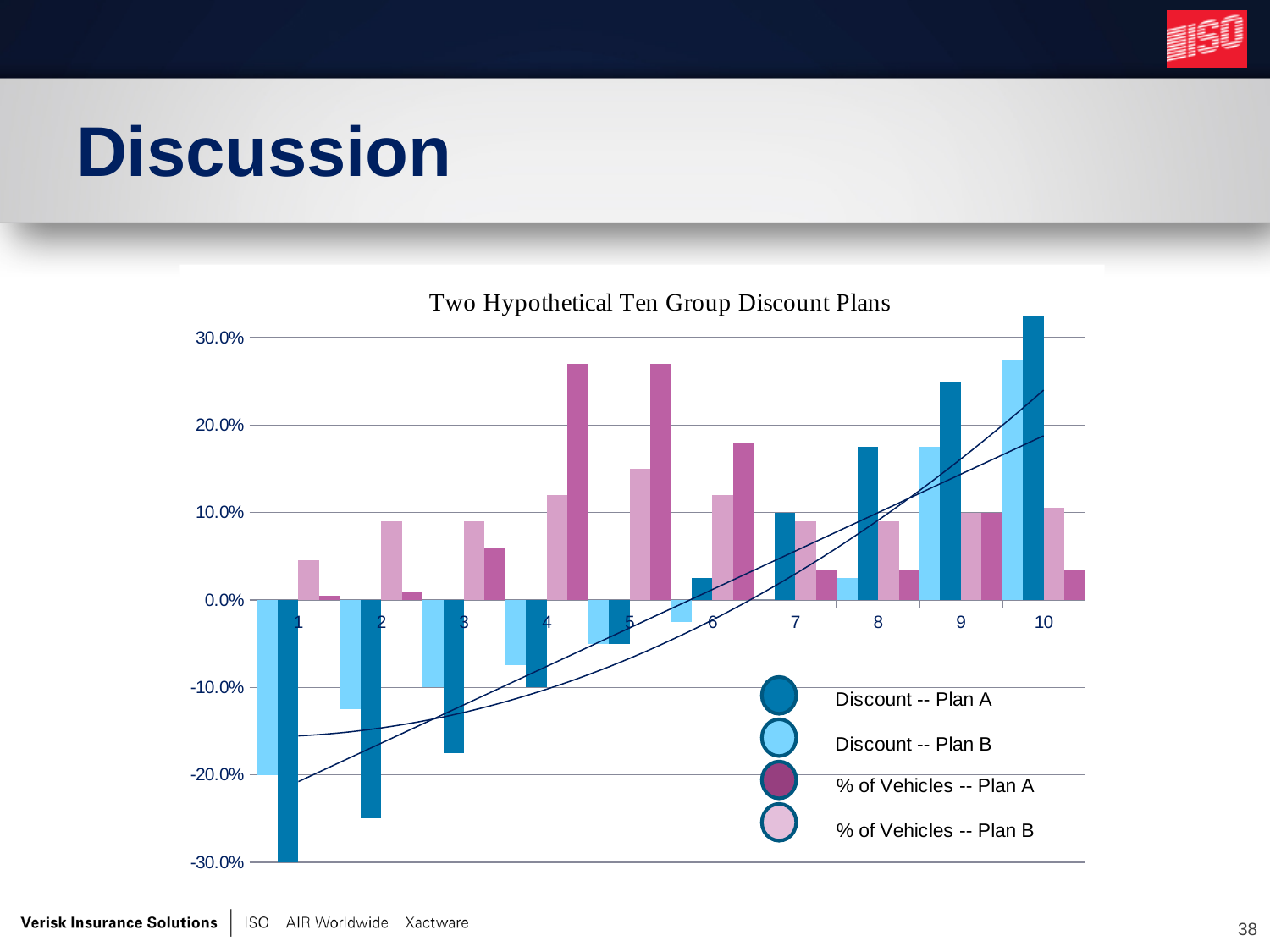
What is the title of the chart? Two Hypothetical Ten Group Discount Plans How many series does the chart legend list? 4 Do the Discount -- Plan A values rise or fall from group 1 to group 10? rise Is the % of Vehicles -- Plan A value for group 4 greater or less than 20.0%? greater How many groups are shown along the x axis of the chart? 10 For which group is the Discount -- Plan A value lowest? 1 For which group is the Discount -- Plan A value highest? 10 Is the Discount -- Plan B value for group 9 greater or less than 10.0%? greater What is the Discount -- Plan A value for group 1? -30.0% For group 2, which is larger: Discount -- Plan A or Discount -- Plan B? Discount -- Plan B Is the Discount -- Plan A value for group 10 greater or less than 30.0%? greater What kind of chart is shown on the slide? bar chart